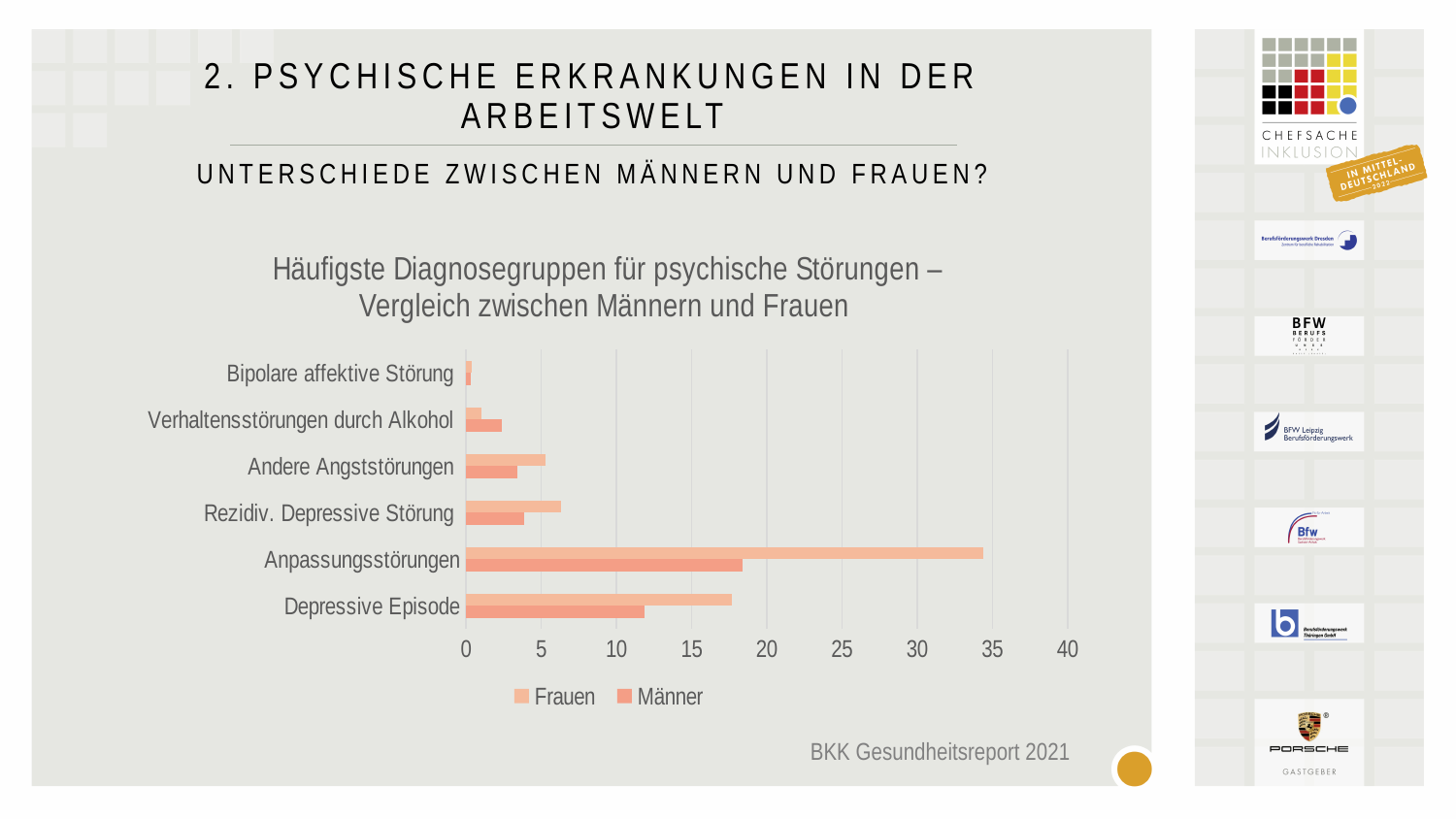
For Depressive Episode, which series has the larger value, Frauen or Männer? Frauen Which diagnosis group has the highest value for Frauen? Anpassungsstörungen For Verhaltensstörungen durch Alkohol, which series has the larger value, Frauen or Männer? Männer How many series does the legend list? 2 Is the Frauen value for Depressive Episode greater or less than 15? greater How many diagnosis groups (categories) are shown on the chart? 6 Which diagnosis group has the highest value for Männer? Anpassungsstörungen Is the Männer value for Anpassungsstörungen greater or less than 20? less What source is cited below the chart? BKK Gesundheitsreport 2021 What are the two series named in the legend? Frauen and Männer What kind of chart is shown on the slide? bar chart Is the Frauen value for Anpassungsstörungen greater or less than 30? greater